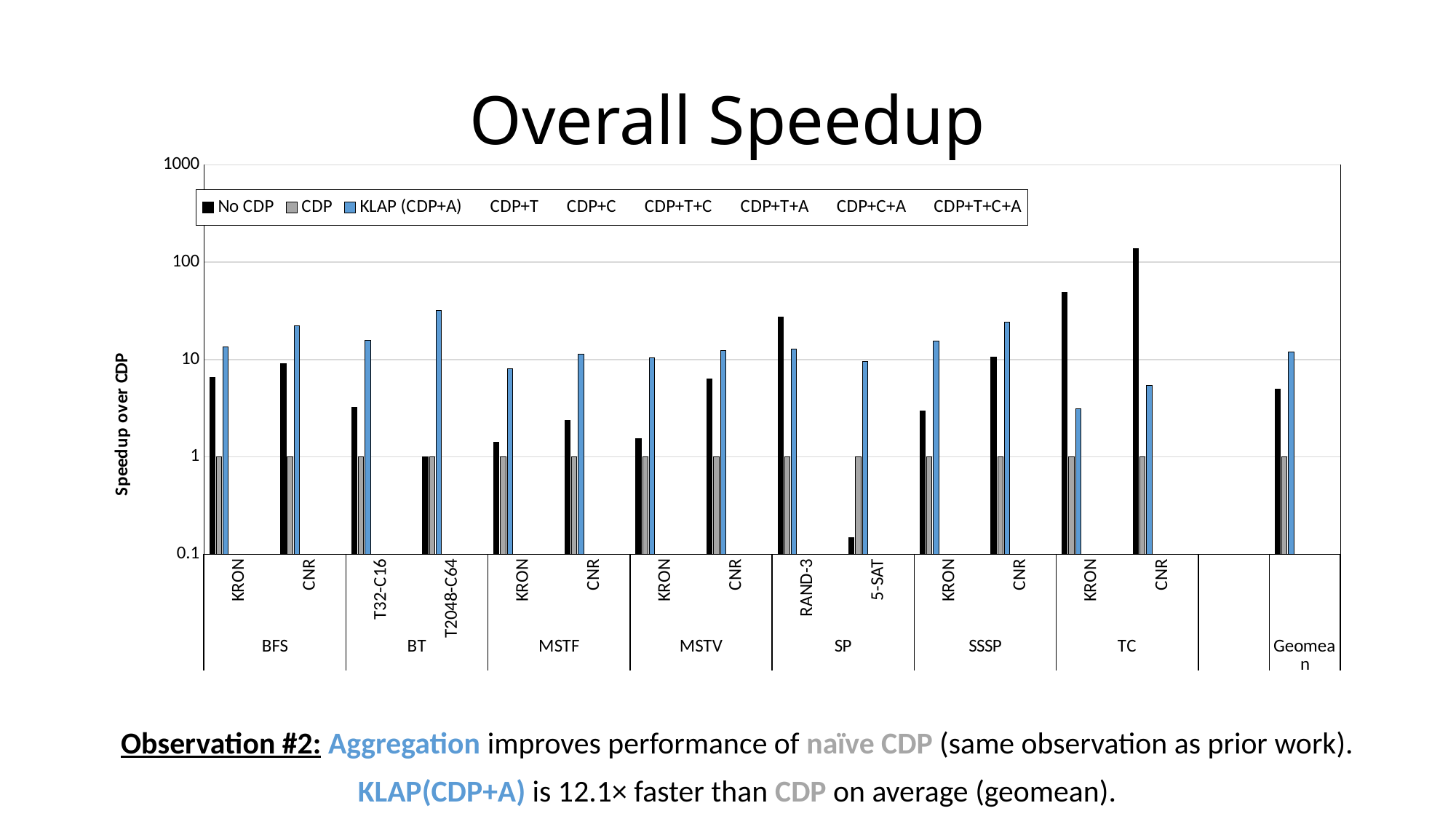
Which category has the lowest No CDP bar? SP 5-SAT Is the No CDP value for TC CNR greater or less than 100? greater For TC KRON, which is larger: No CDP or KLAP (CDP+A)? No CDP Which category has the highest KLAP (CDP+A) bar? BT T2048-C64 What kind of chart is shown on the slide? bar chart What is the CDP value for BFS KRON? 1 What is the title of the chart? Overall Speedup What is the label of the y axis? Speedup over CDP How many benchmark groups (excluding Geomean) are shown along the x axis? 7 Which category has the highest No CDP bar? TC CNR Is the KLAP (CDP+A) value for TC CNR greater or less than 10? less How many series does the legend list? 9